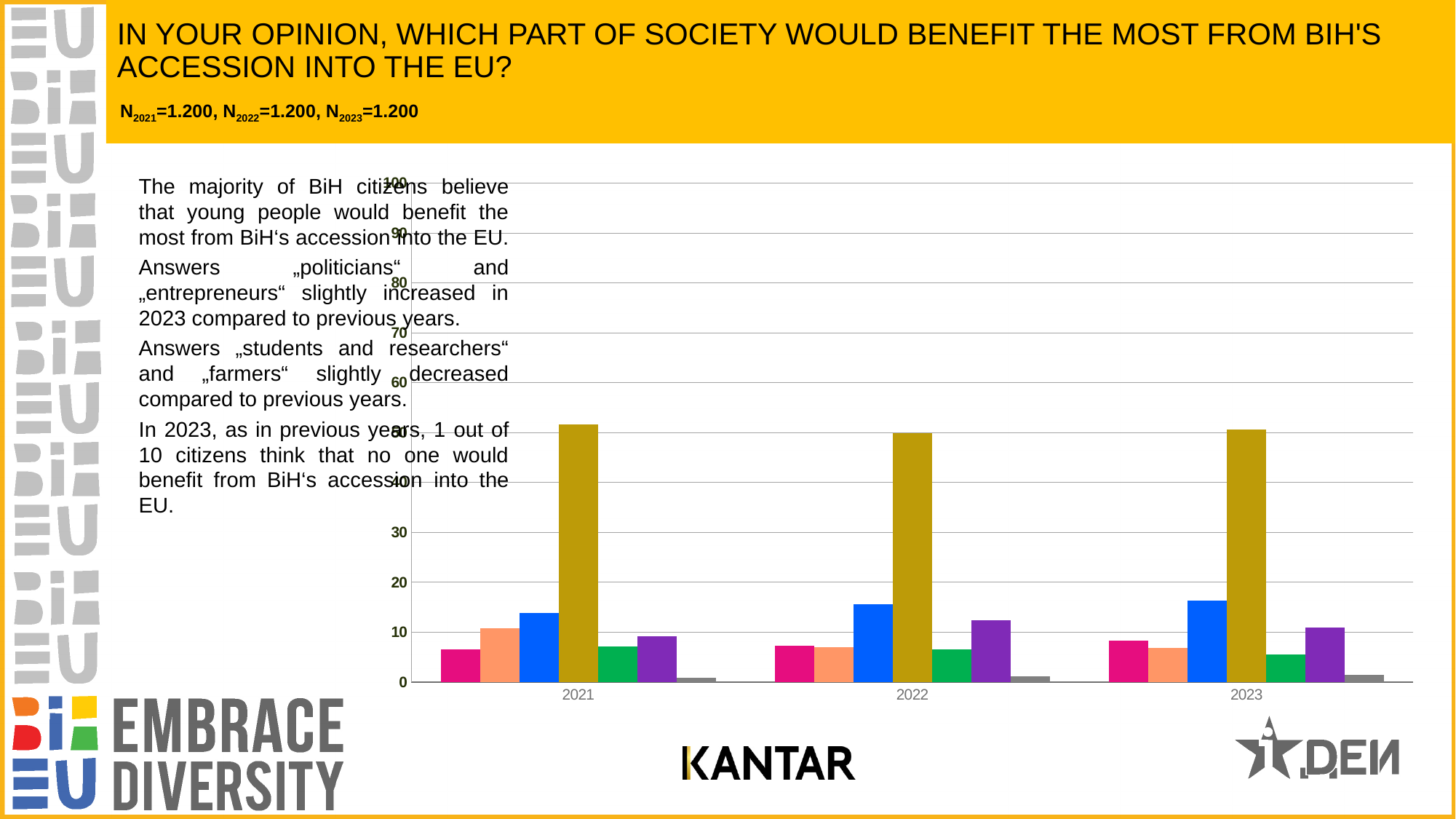
Which coloured bar is the tallest in every year group of the chart? the gold bar How many year categories are shown on the x axis of the chart? 3 Is the value of the green bar for 2023 greater or less than 10? less Is the value of the purple bar for 2022 greater or less than 10? greater Which year categories are labelled on the x axis of the chart? 2021, 2022, 2023 Is the value of the blue bar for 2023 greater or less than 20? less How many bars are plotted in each year group of the chart? 7 What is the highest value shown on the y axis of the chart? 100 What kind of chart is shown on the slide? bar chart In 2023, which is larger: the blue bar or the purple bar? the blue bar Does the blue bar rise or fall from 2021 to 2023? rise